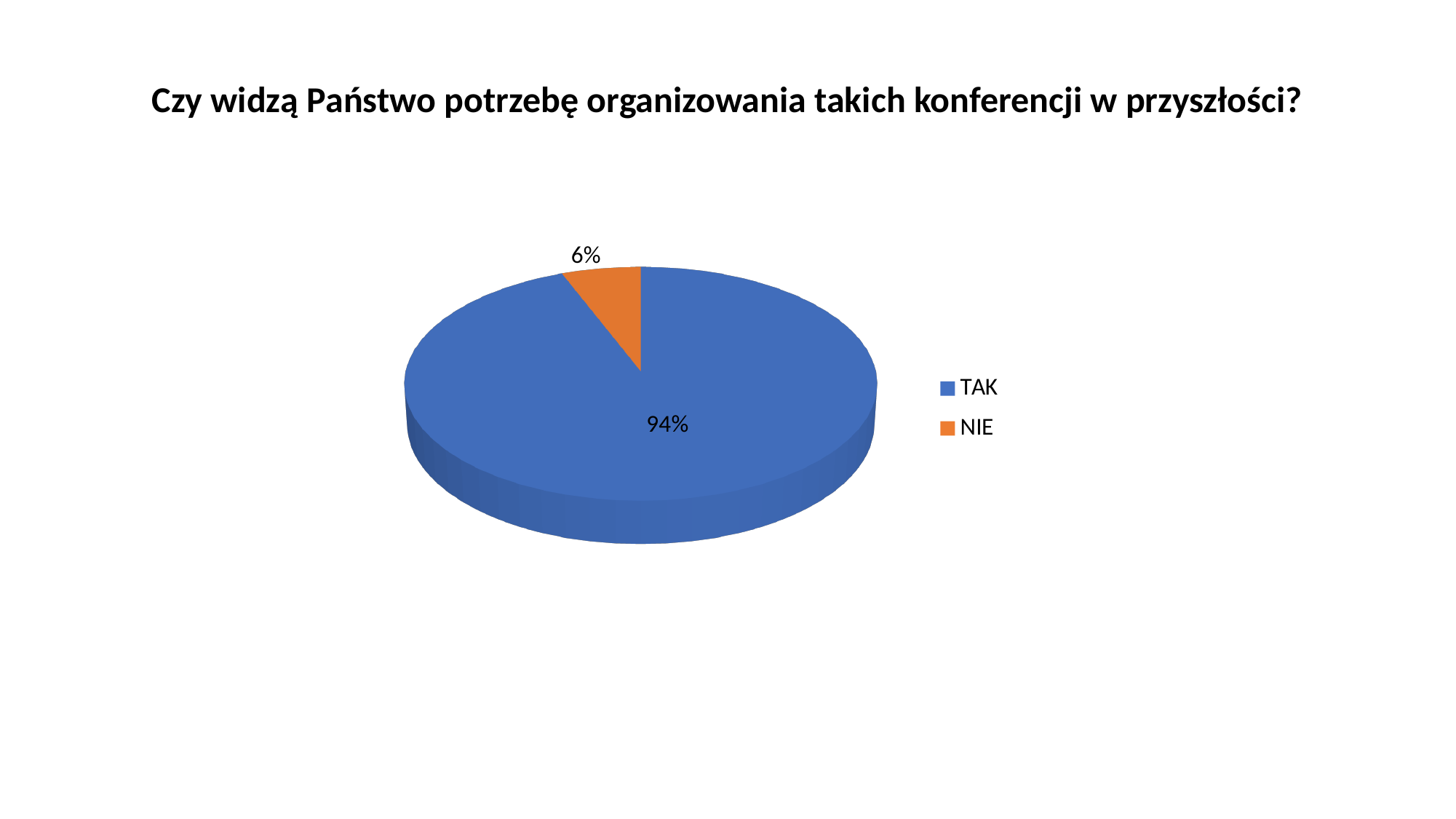
What is the difference in percentage points between TAK and NIE? 88 What share of the pie does TAK represent? 94% Which category has the smallest slice of the pie? NIE What share of the pie does NIE represent? 6% How many entries does the legend list? 2 What is the title of the chart? Czy widzą Państwo potrzebę organizowania takich konferencji w przyszłości? Which category has the largest slice of the pie? TAK Which is larger, the share for TAK or the share for NIE? TAK What colour is the slice for NIE? orange How many categories does the pie chart show? 2 What kind of chart is shown on the slide? pie chart